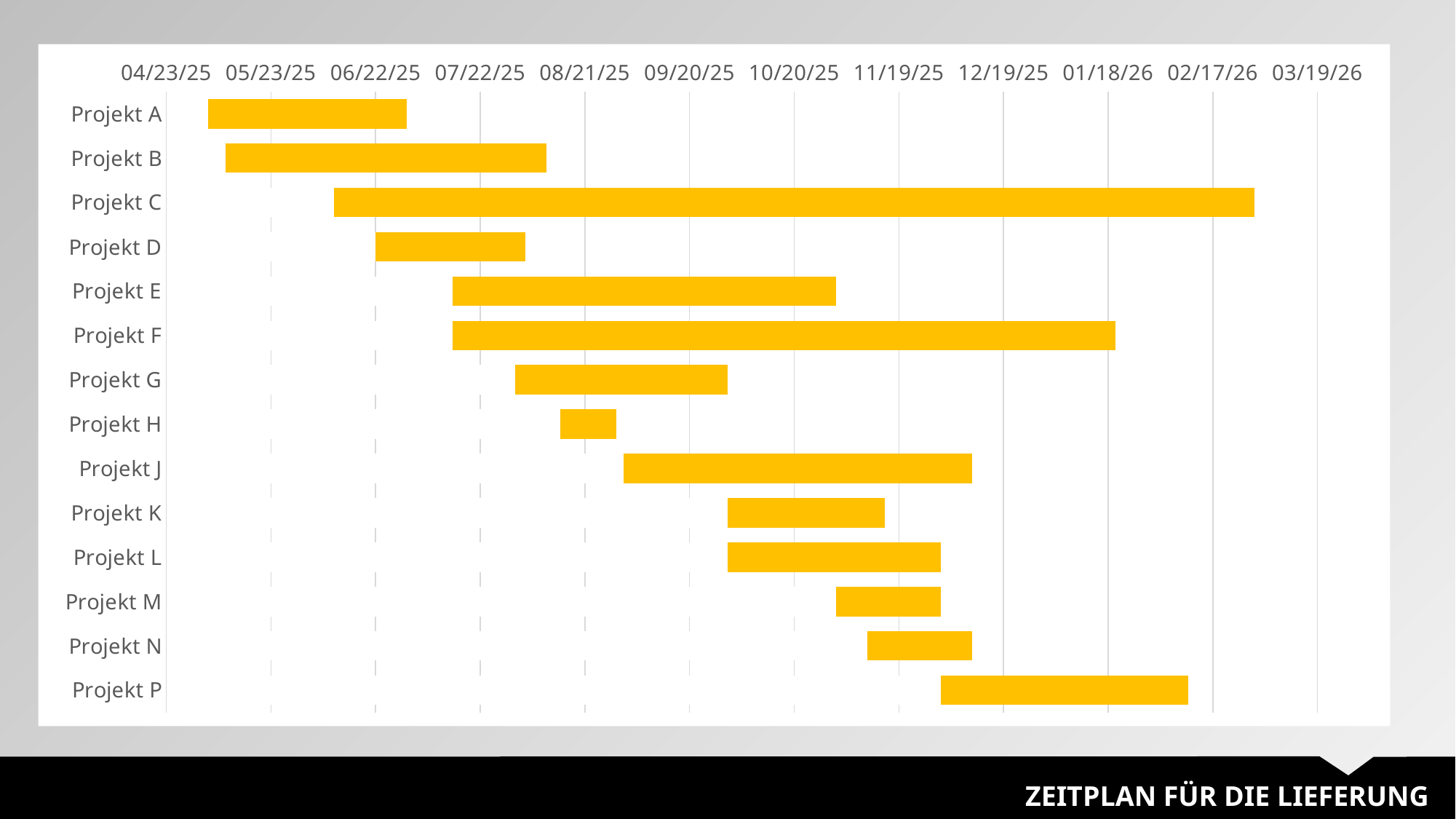
Which project starts last on the timeline? Projekt P Does Projekt P start before or after 11/19/25? after Which bar is longer, Projekt C or Projekt D? Projekt C Which bar is longer, Projekt F or Projekt K? Projekt F Which project has the shortest bar on the chart? Projekt H What kind of chart is shown on the slide? Bar chart (Gantt chart) Which project ends latest on the timeline? Projekt C Which project has the longest bar on the chart? Projekt C What is the title shown at the bottom of the slide? ZEITPLAN FÜR DIE LIEFERUNG Which project starts earliest on the timeline? Projekt A How many projects are listed on the chart? 14 Does Projekt C end before or after 02/17/26? after